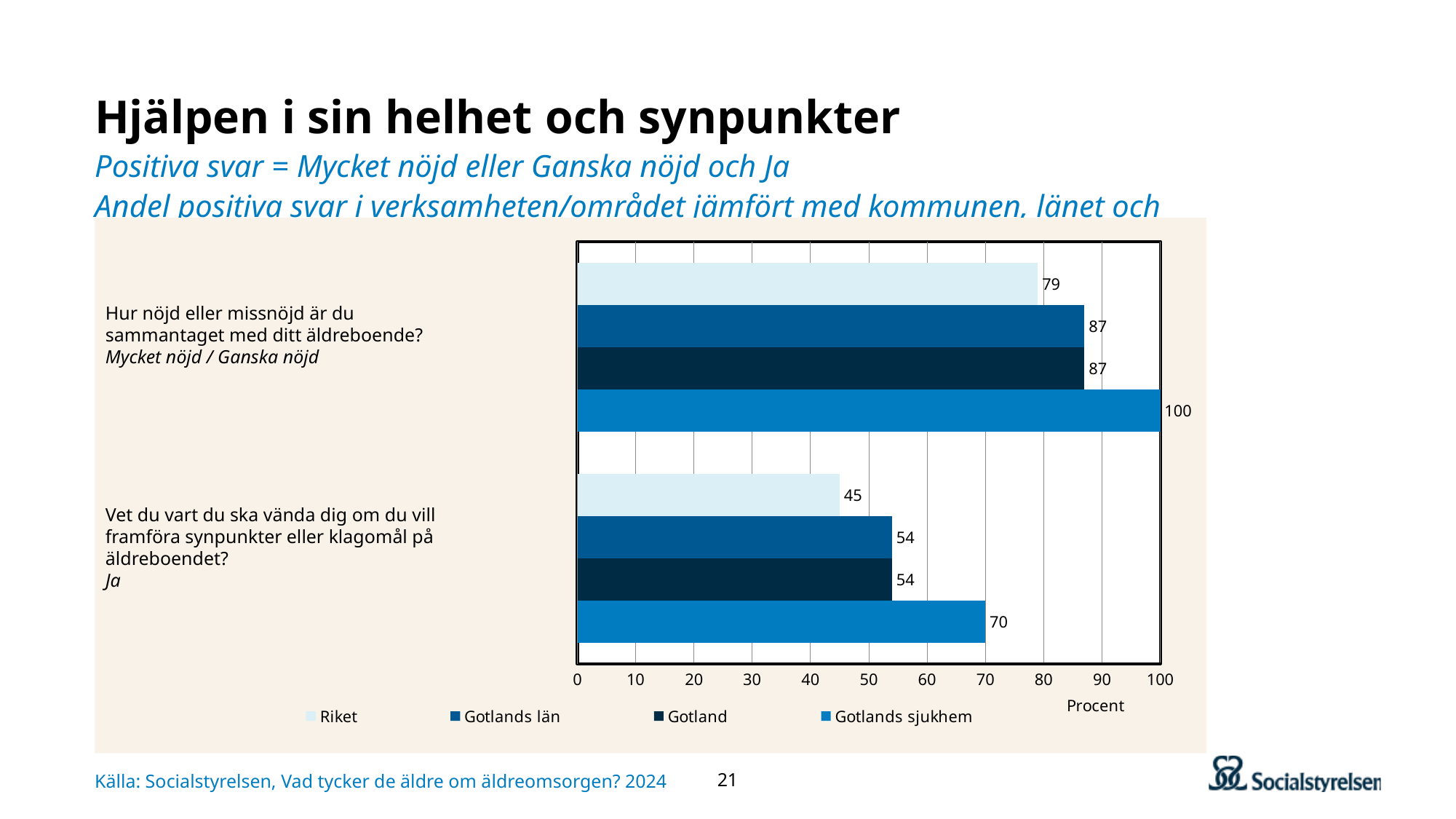
What is the value for Gotland on the question "Vet du vart du ska vända dig om du vill framföra synpunkter eller klagomål på äldreboendet?"? 54 What kind of chart is shown on the slide? Bar chart What is the difference between Gotlands sjukhem and Riket on the question "Vet du vart du ska vända dig om du vill framföra synpunkter eller klagomål på äldreboendet?"? 25 How many series does the legend list? 4 Which is larger: the Riket value for "Hur nöjd eller missnöjd är du sammantaget med ditt äldreboende?" or the Gotlands sjukhem value for "Vet du vart du ska vända dig om du vill framföra synpunkter eller klagomål på äldreboendet?"? Riket value for "Hur nöjd eller missnöjd är du sammantaget med ditt äldreboende?" What is the label on the horizontal axis of the chart? Procent What is the value for Gotlands sjukhem on the question "Hur nöjd eller missnöjd är du sammantaget med ditt äldreboende?"? 100 What is the value for Gotlands län on the question "Hur nöjd eller missnöjd är du sammantaget med ditt äldreboende?"? 87 Which series has the highest value on the question "Vet du vart du ska vända dig om du vill framföra synpunkter eller klagomål på äldreboendet?"? Gotlands sjukhem What is the difference between Gotlands sjukhem and Gotland on the question "Hur nöjd eller missnöjd är du sammantaget med ditt äldreboende?"? 13 Which series has the lowest value on the question "Hur nöjd eller missnöjd är du sammantaget med ditt äldreboende?"? Riket What is the value for Riket on the question "Vet du vart du ska vända dig om du vill framföra synpunkter eller klagomål på äldreboendet?"? 45